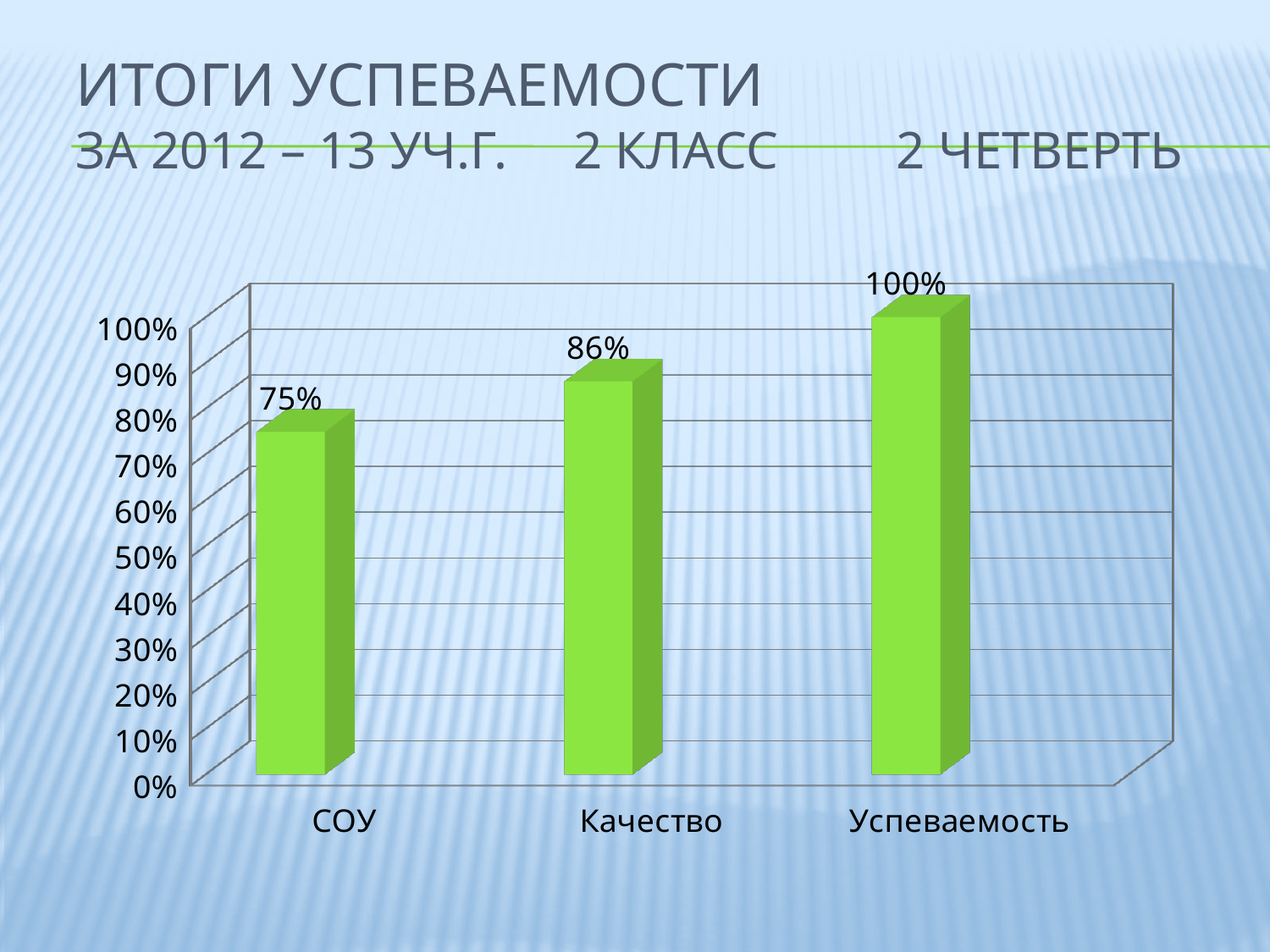
Do the values rise or fall from left to right along the x axis? rise Is the value for Качество greater or less than 80%? greater Which category has the highest value? Успеваемость What kind of chart is shown on the slide? bar chart What is the value for СОУ? 75% What is the value for Качество? 86% What is the difference between the values for Качество and СОУ? 11% Which category has the lowest value? СОУ What is the difference between the values for Успеваемость and СОУ? 25% How many categories are shown on the x axis? 3 Which is larger, the value for Качество or the value for СОУ? Качество What is the value for Успеваемость? 100%